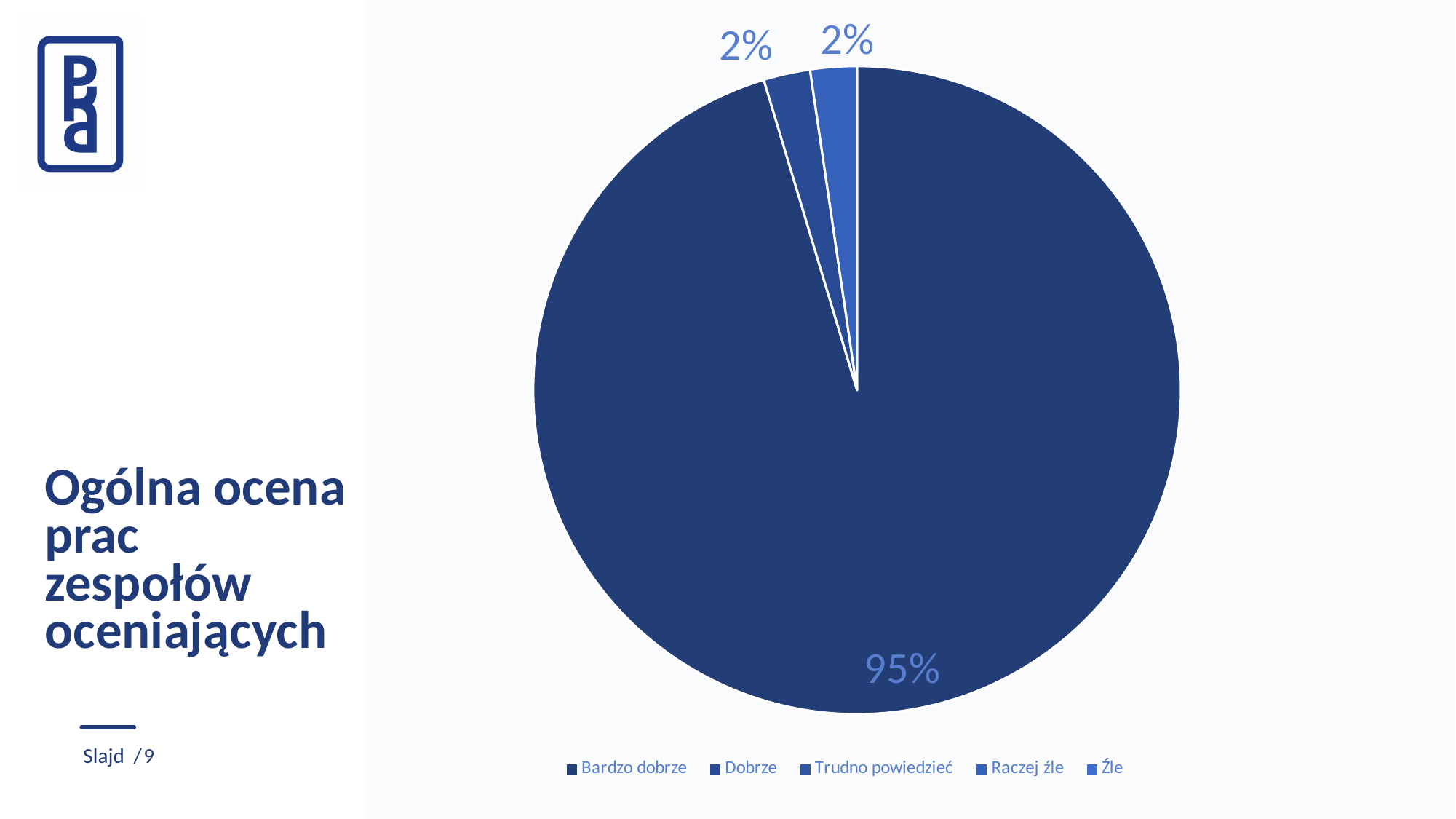
What is the difference in percentage points between the 95% slice and one of the 2% slices? 93 What value is printed on the largest slice of the pie chart? 95% Which category has the largest slice in the pie chart? Bardzo dobrze How many entries does the legend of the pie chart list? 5 How many slices in the pie chart are labelled 2%? 2 What share of the pie does the largest slice (Bardzo dobrze) represent? 95% Is the largest slice of the pie chart larger or smaller than a 2% slice? larger What is the title of the slide containing the pie chart? Ogólna ocena prac zespołów oceniających What is the first entry listed in the pie chart's legend? Bardzo dobrze How many slices with printed data labels does the pie chart have? 3 What kind of chart is shown on the slide? pie chart